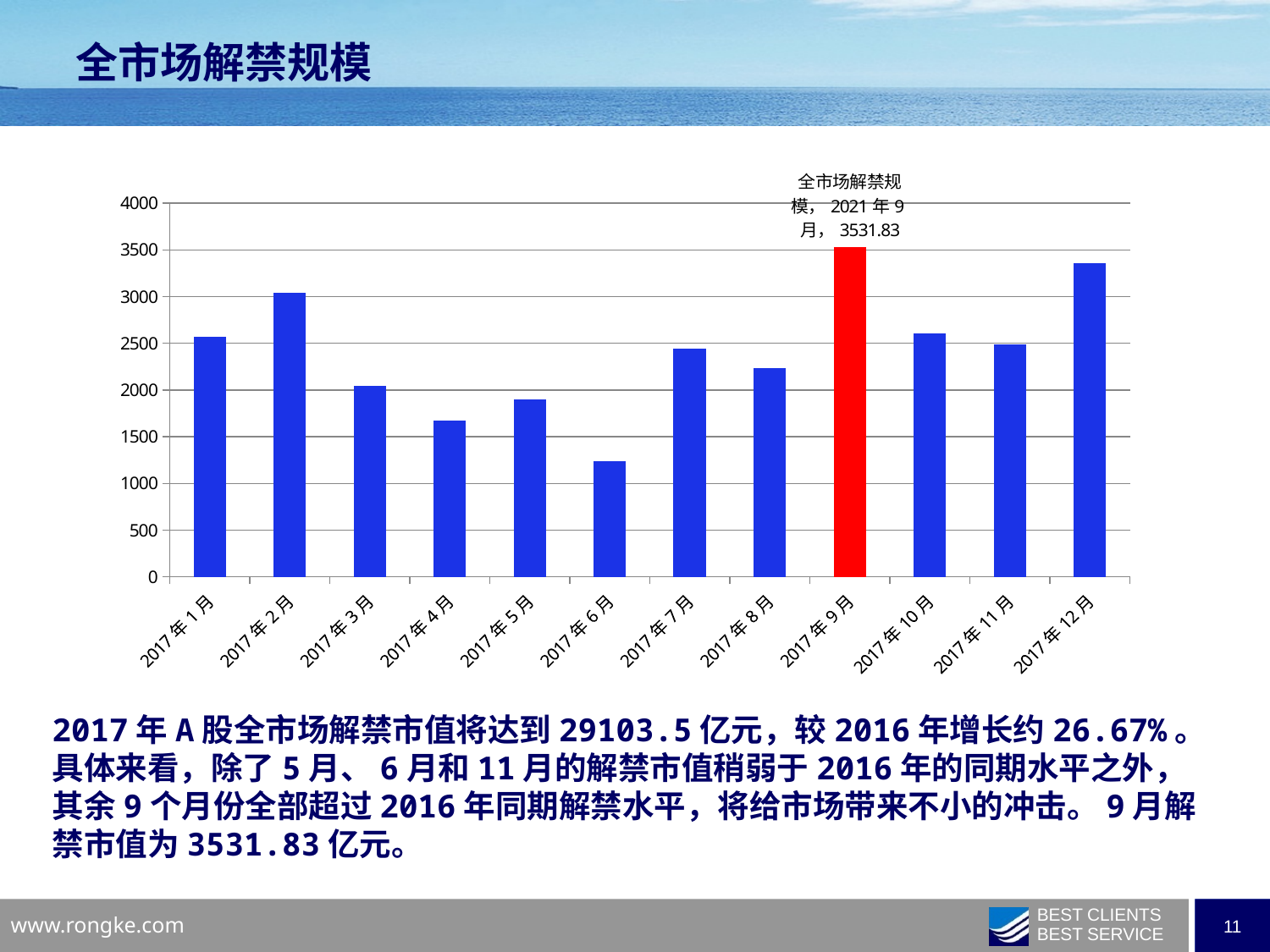
What is the value for 2017年9月 shown by the data label on the chart? 3531.83 Is the value for 2017年6月 greater or less than 1500? less Is the value for 2017年4月 greater or less than 2000? less Which is larger, the value for 2017年4月 or 2017年5月? 2017年5月 Which month's bar is coloured red on the chart? 2017年9月 Which is larger, the value for 2017年2月 or 2017年12月? 2017年12月 Which month has the highest bar on the chart? 2017年9月 What kind of chart is shown on the slide? bar chart Which month has the lowest bar on the chart? 2017年6月 Is the value for 2017年12月 greater or less than 3000? greater How many months are plotted on the chart? 12